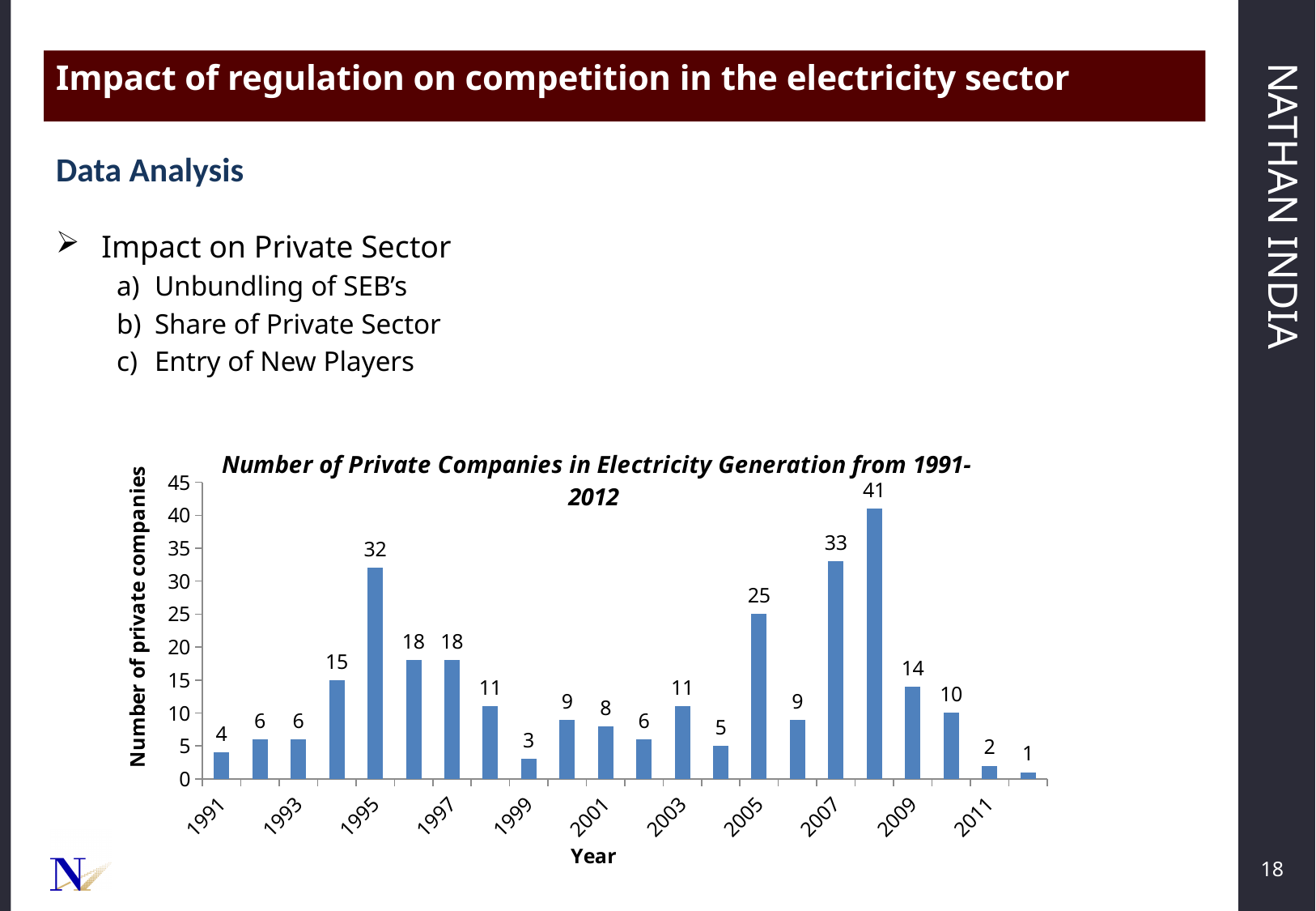
What type of chart is shown on the slide? Bar chart What is the highest value shown in the chart? 41 What is the difference between the number of private companies in 2007 and in 2005? 8 What is the number of private companies in 2011? 2 What is the number of private companies in 1995? 32 Which year has the lowest number of private companies? 2012 Which year has the highest number of private companies? 2008 What is the number of private companies in 1991? 4 What is the number of private companies in 2007? 33 What is the title of the chart? Number of Private Companies in Electricity Generation from 1991-2012 Which year has more private companies, 1995 or 2007? 2007 How many years (bars) are plotted in the chart? 22